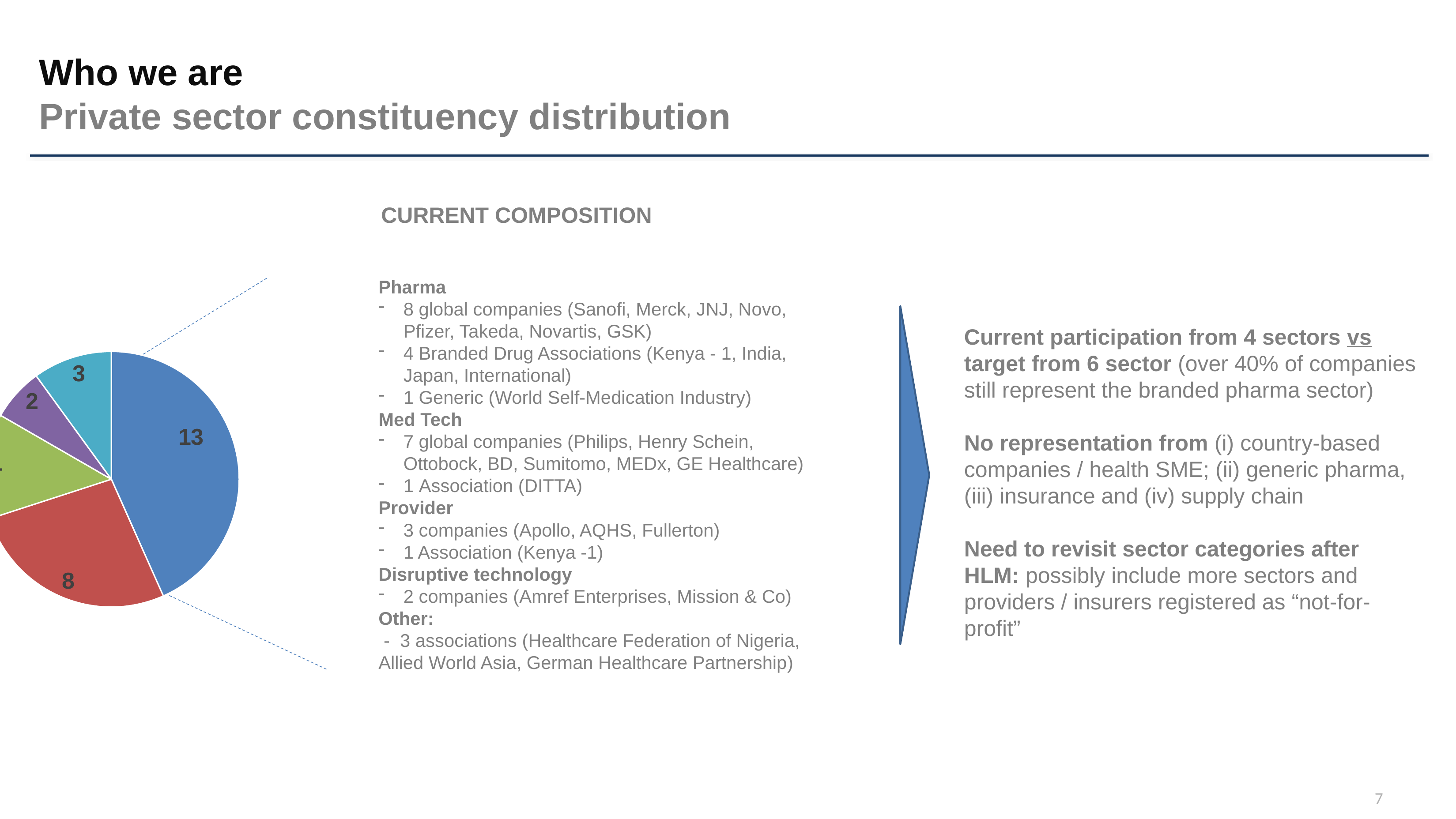
What is the value shown on the purple slice of the pie chart? 2 What is the value shown on the teal slice of the pie chart? 3 Which is larger in the pie chart, the blue slice or the red slice? the blue slice What is the value shown on the smallest slice of the pie chart? 2 What kind of chart is shown on the slide? pie chart What is the value shown on the red slice of the pie chart? 8 What is the difference between the blue slice (13) and the red slice (8) in the pie chart? 5 What colour is the largest slice of the pie chart? blue What is the value shown on the largest slice of the pie chart? 13 What is the difference between the largest slice (13) and the teal slice (3) in the pie chart? 10 Which is larger in the pie chart, the teal slice or the purple slice? the teal slice What is the difference between the teal slice (3) and the purple slice (2) in the pie chart? 1